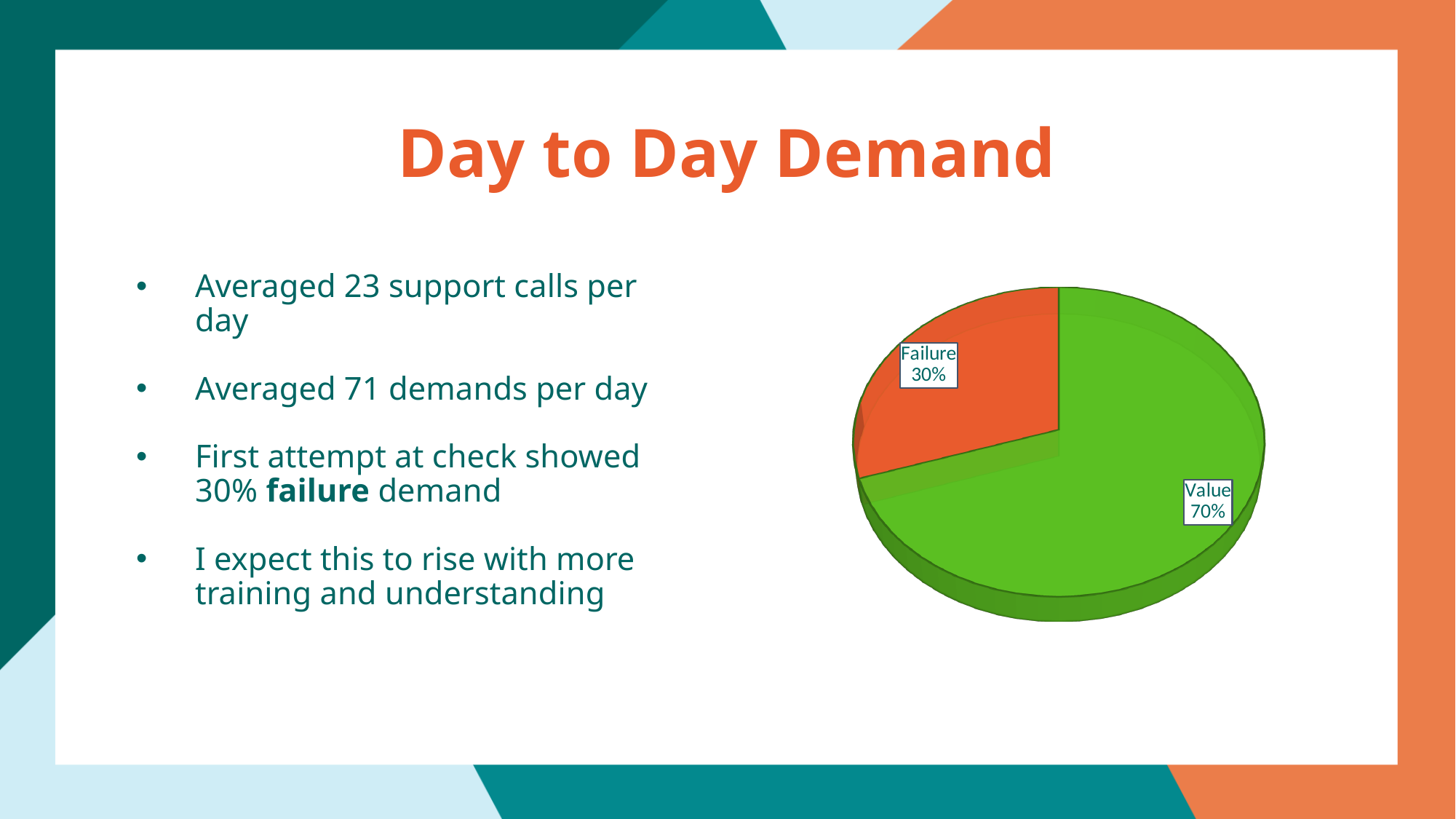
Which is larger in the pie chart, Failure or Value? Value What kind of chart is shown on the slide? pie chart What colour is the Failure slice in the pie chart? orange What share of the pie does the Failure slice represent? 30% What is the difference in percentage points between the Value slice and the Failure slice? 40% What share of the pie does the Value slice represent? 70% What colour is the Value slice in the pie chart? green Which slice of the pie chart is the smallest? Failure How many slices does the pie chart have? 2 Which slice of the pie chart is the largest? Value